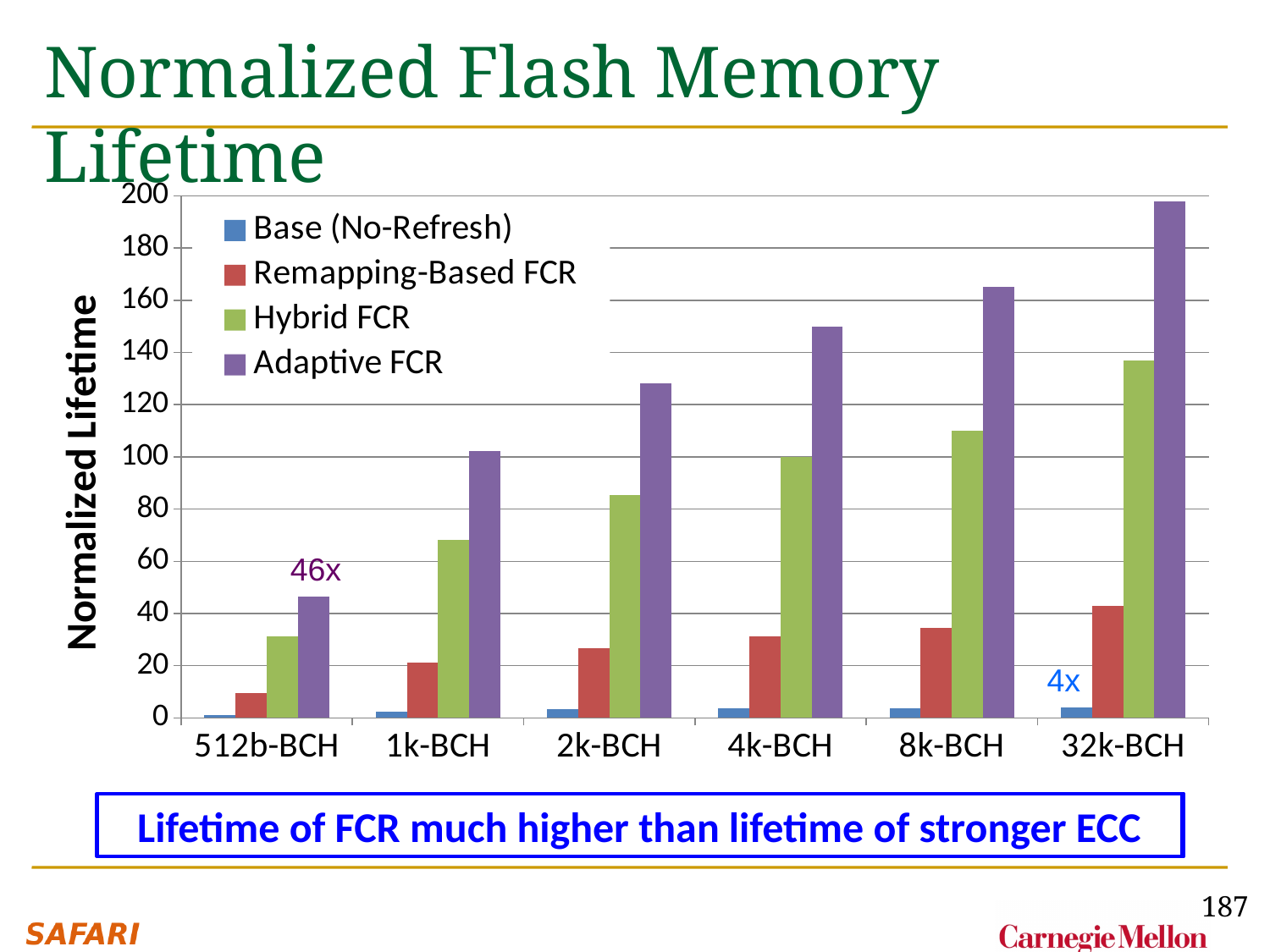
What annotation is printed above the Adaptive FCR bar for 512b-BCH? 46x Which series has the highest value for 32k-BCH? Adaptive FCR What is the label on the y axis? Normalized Lifetime Is the value of Hybrid FCR for 1k-BCH greater or less than 80? less Do the Adaptive FCR values rise or fall as the ECC strength increases from 512b-BCH to 32k-BCH? rise How many series does the legend list? 4 What kind of chart is shown on the slide? bar chart How many ECC categories are shown along the x axis? 6 Which is larger for 2k-BCH: Hybrid FCR or Remapping-Based FCR? Hybrid FCR Is the value of Remapping-Based FCR for 32k-BCH greater or less than 40? greater Is the value of Adaptive FCR for 8k-BCH greater or less than 160? greater Which series has the lowest value for 512b-BCH? Base (No-Refresh)